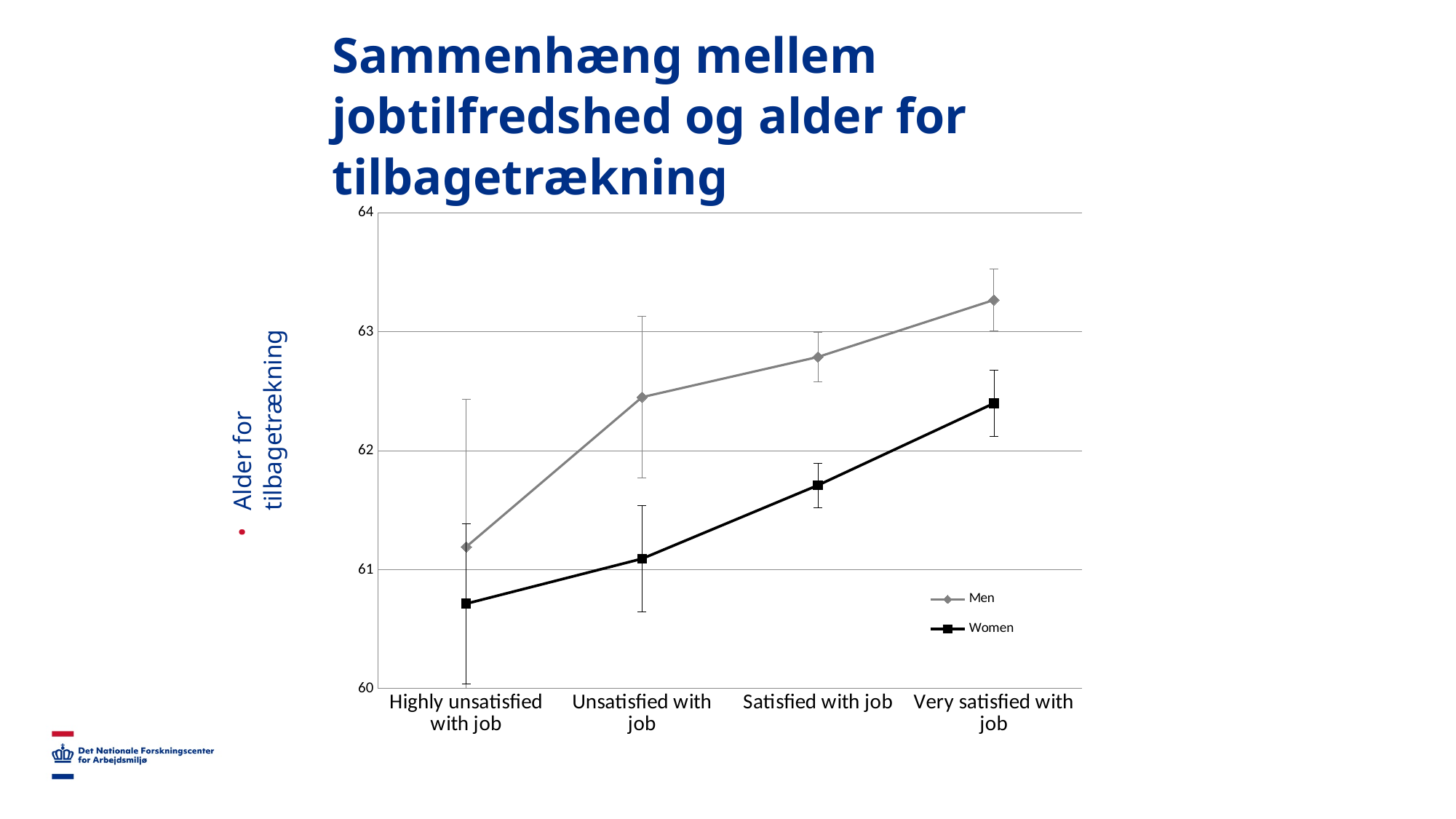
Do the values for Men rise or fall from 'Highly unsatisfied with job' to 'Very satisfied with job'? rise How many job satisfaction categories are shown on the x axis? 4 Which category has the lowest value for Women? Highly unsatisfied with job Which category has the highest value for Men? Very satisfied with job Is the value for Men at 'Very satisfied with job' greater or less than 63? greater Is the value for Women at 'Very satisfied with job' greater or less than 62? greater How many series does the legend list? 2 For 'Satisfied with job', which series has the larger value, Men or Women? Men What kind of chart is shown on the slide? line chart Do the values for Women rise or fall along the x axis? rise Is the value for Women at 'Highly unsatisfied with job' greater or less than 61? less What are the two series named in the legend? Men and Women